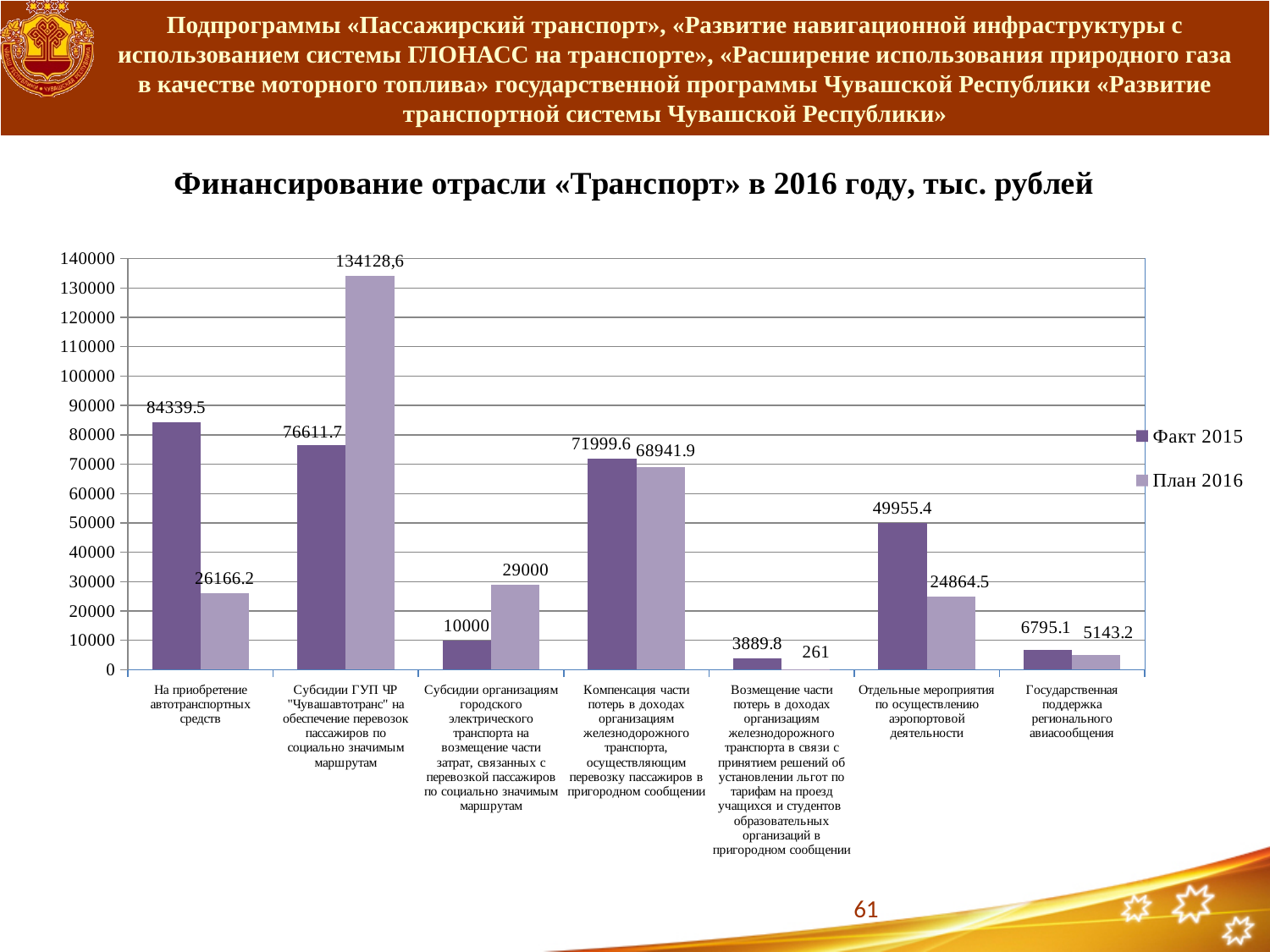
What is the difference between the Факт 2015 and План 2016 values for «На приобретение автотранспортных средств»? 58173.3 What is the difference between the План 2016 and Факт 2015 values for «Субсидии организациям городского электрического транспорта»? 19000 What is the План 2016 value for «Отдельные мероприятия по осуществлению аэропортовой деятельности»? 24864.5 How many categories are shown on the x axis of the chart? 7 For «Компенсация части потерь в доходах организациям железнодорожного транспорта, осуществляющим перевозку пассажиров в пригородном сообщении», which is larger: Факт 2015 or План 2016? Факт 2015 What type of chart is shown on the slide? Bar chart What is the Факт 2015 value for «Государственная поддержка регионального авиасообщения»? 6795.1 Which category has the highest План 2016 value? Субсидии ГУП ЧР "Чувашавтотранс" на обеспечение перевозок пассажиров по социально значимым маршрутам What is the План 2016 value for «Субсидии ГУП ЧР "Чувашавтотранс" на обеспечение перевозок пассажиров по социально значимым маршрутам»? 134128,6 How many series does the legend list? 2 What is the Факт 2015 value for «На приобретение автотранспортных средств»? 84339.5